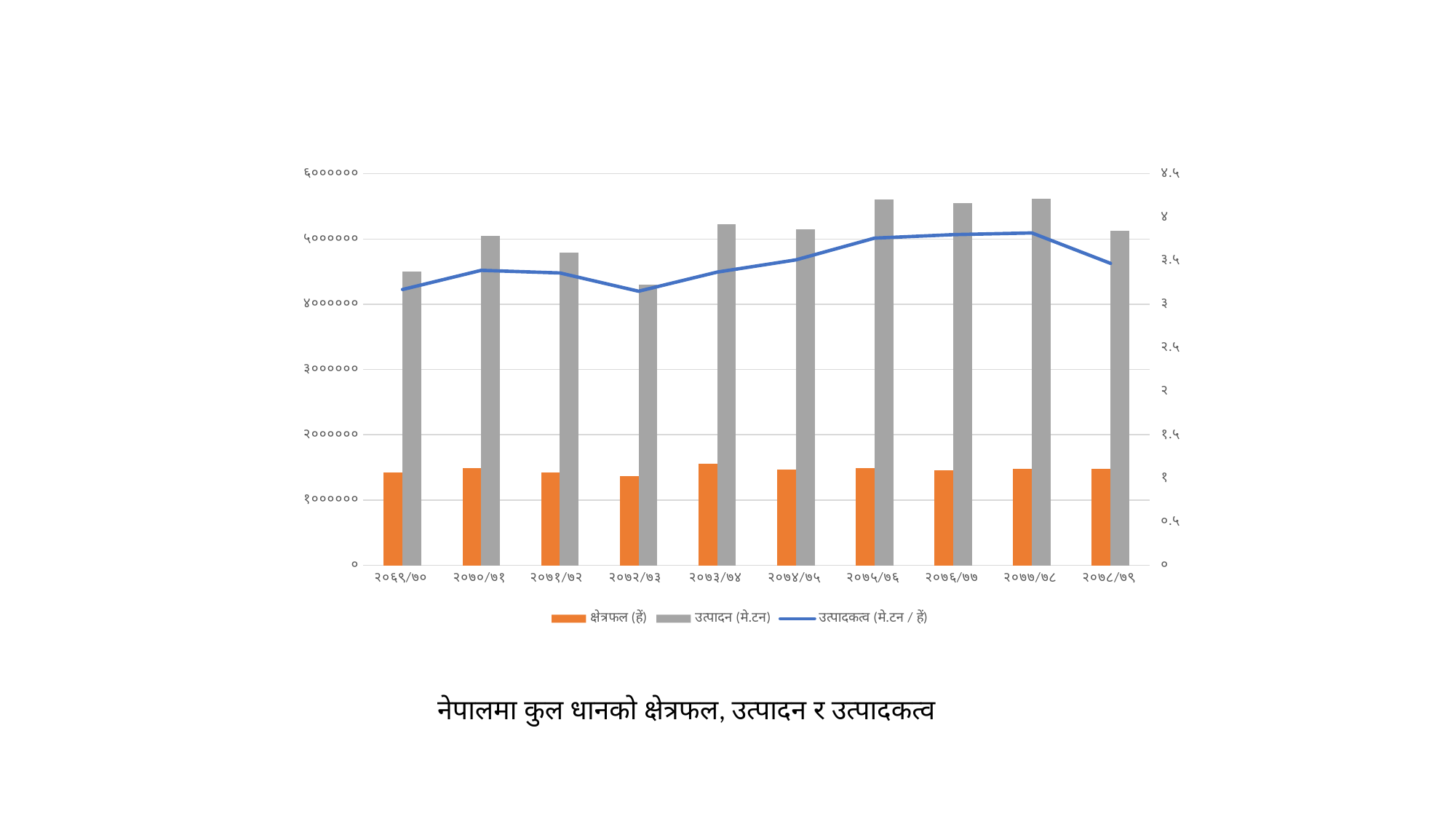
How many fiscal years (categories) are shown on the x axis? 10 How many series does the legend list? 3 Which series is drawn as a blue line? उत्पादकत्व (मे.टन / हें) Is the उत्पादन (मे.टन) value for २०७५/७६ greater or less than ५०००००० on the left axis? greater In which year is उत्पादन (मे.टन) the lowest? २०७२/७३ Does उत्पादन (मे.टन) generally rise or fall from २०६९/७० to २०७७/७८? rise In which year is क्षेत्रफल (हें) the highest? २०७३/७४ What is the title of the chart? नेपालमा कुल धानको क्षेत्रफल, उत्पादन र उत्पादकत्व What kind of chart is shown on the slide? A combined bar and line chart Which year has the larger उत्पादन (मे.टन): २०७१/७२ or २०७३/७४? २०७३/७४ Is the उत्पादन (मे.टन) value for २०६९/७० greater or less than ५०००००० on the left axis? less Is the उत्पादकत्व (मे.टन / हें) value for २०७८/७९ greater or less than ३ on the right axis? greater